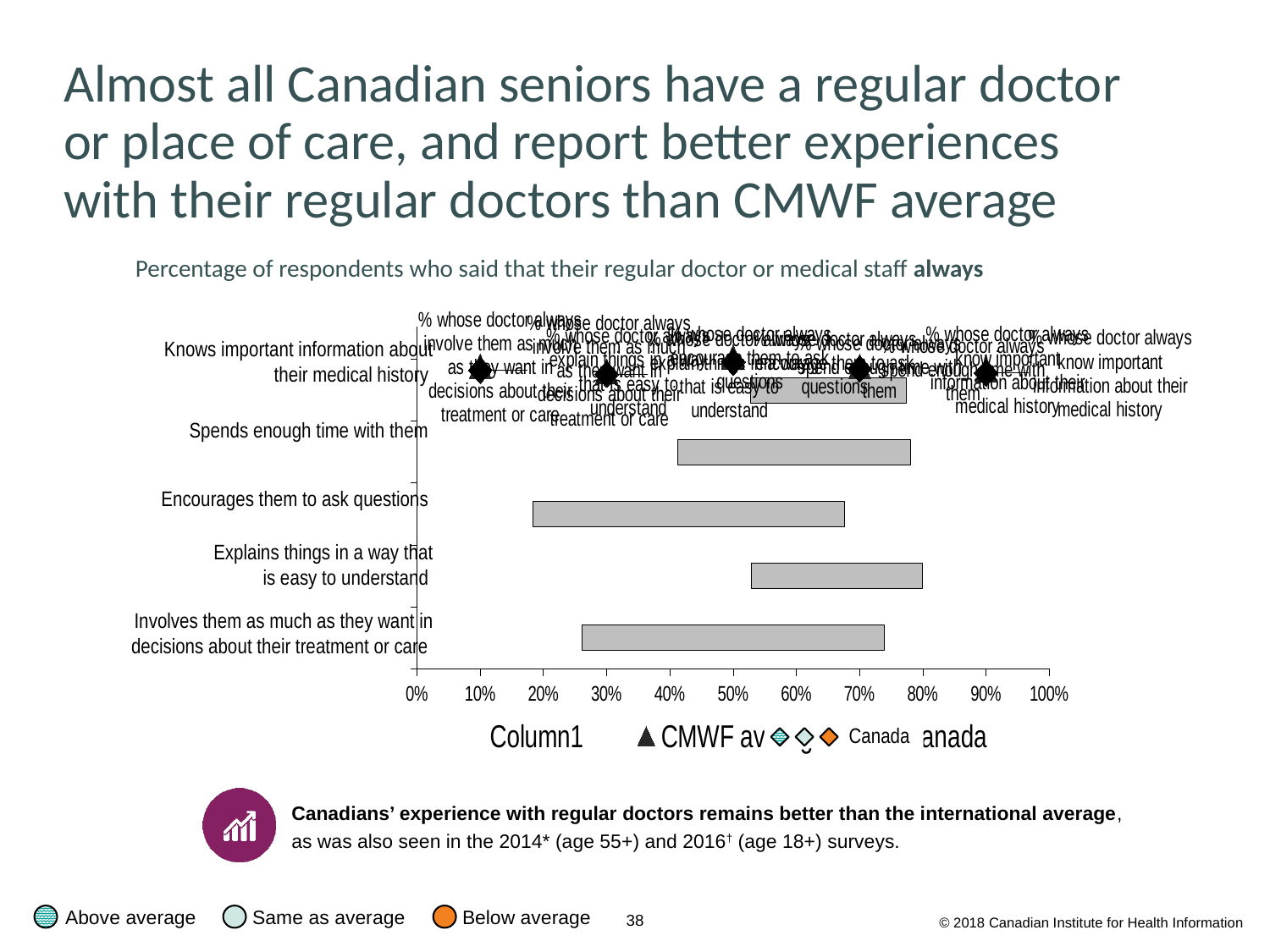
Is the right end of the bar for 'Spends enough time with them' greater or less than 70%? greater Which category is listed at the top of the chart's vertical axis? Knows important information about their medical history Is the left end of the bar for 'Encourages them to ask questions' greater or less than 30%? less Is the right end of the bar for 'Explains things in a way that is easy to understand' greater or less than 70%? greater Which category's bar extends furthest to the left on the chart? Encourages them to ask questions What kind of chart is shown on the slide? bar chart What is the highest value shown on the horizontal axis of the chart? 100% How many categories are listed on the vertical axis of the chart? 5